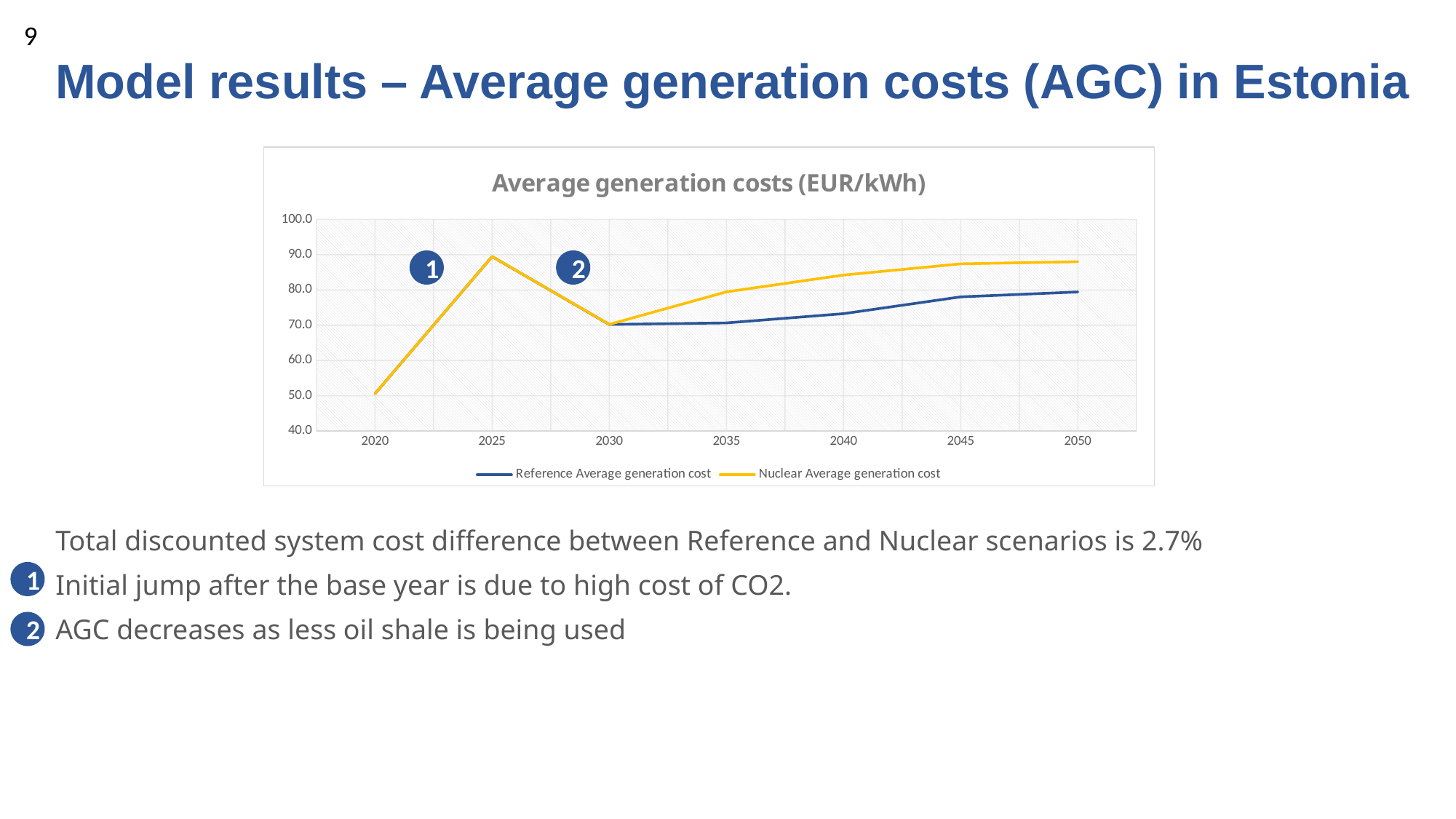
Does the Reference Average generation cost rise or fall from 2030 to 2050? Rise How many series does the chart legend list? 2 Is the Nuclear Average generation cost in 2025 greater or less than 80.0? greater Is the Nuclear Average generation cost in 2020 greater or less than 60.0? less Is the Reference Average generation cost in 2040 greater or less than 80.0? less In 2050, which series has the higher value: Reference Average generation cost or Nuclear Average generation cost? Nuclear Average generation cost In which year is the Nuclear Average generation cost lowest? 2020 What is the title of the chart? Average generation costs (EUR/kWh) Which series is drawn in yellow in the chart? Nuclear Average generation cost What kind of chart is shown on the slide? Line chart How many years are labelled on the x axis of the chart? 7